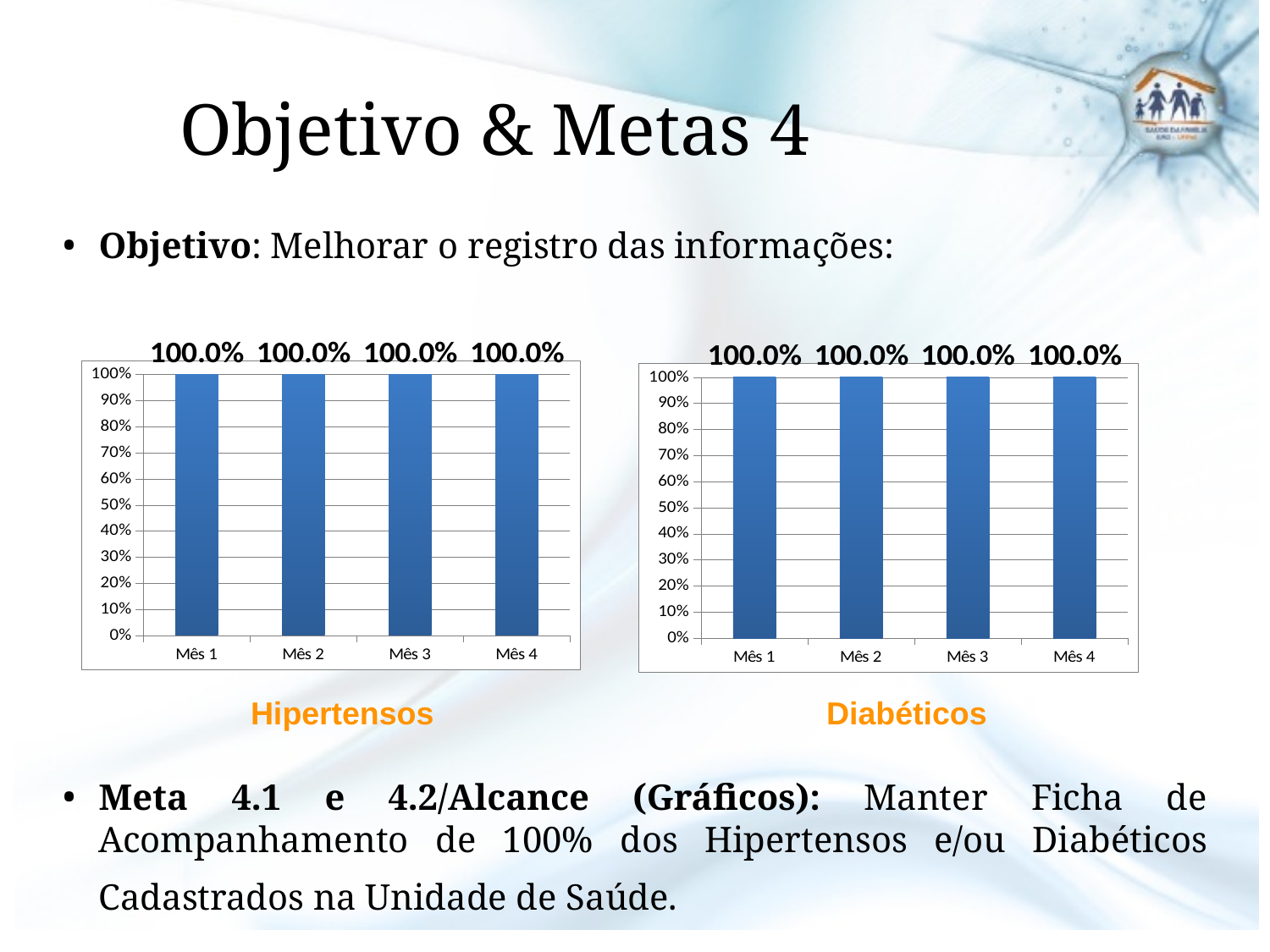
In the Diabéticos chart, what is the value for Mês 2? 100.0% In the Hipertensos chart, what is the value for Mês 3? 100.0% In the Hipertensos chart, what is the value for Mês 1? 100.0% How many categories are shown on the x axis of the Hipertensos chart? 4 In the Hipertensos chart, do the values rise, fall or stay the same from Mês 1 to Mês 4? Stay the same What kind of chart is the Hipertensos chart? Bar chart In the Diabéticos chart, what is the difference between the values for Mês 1 and Mês 4? 0.0% What kind of chart is the Diabéticos chart? Bar chart What is the label shown below the left chart? Hipertensos How many bars does the Diabéticos chart have? 4 In the Diabéticos chart, what is the value for Mês 4? 100.0% In the Diabéticos chart, is the value for Mês 3 greater or less than 50%? greater